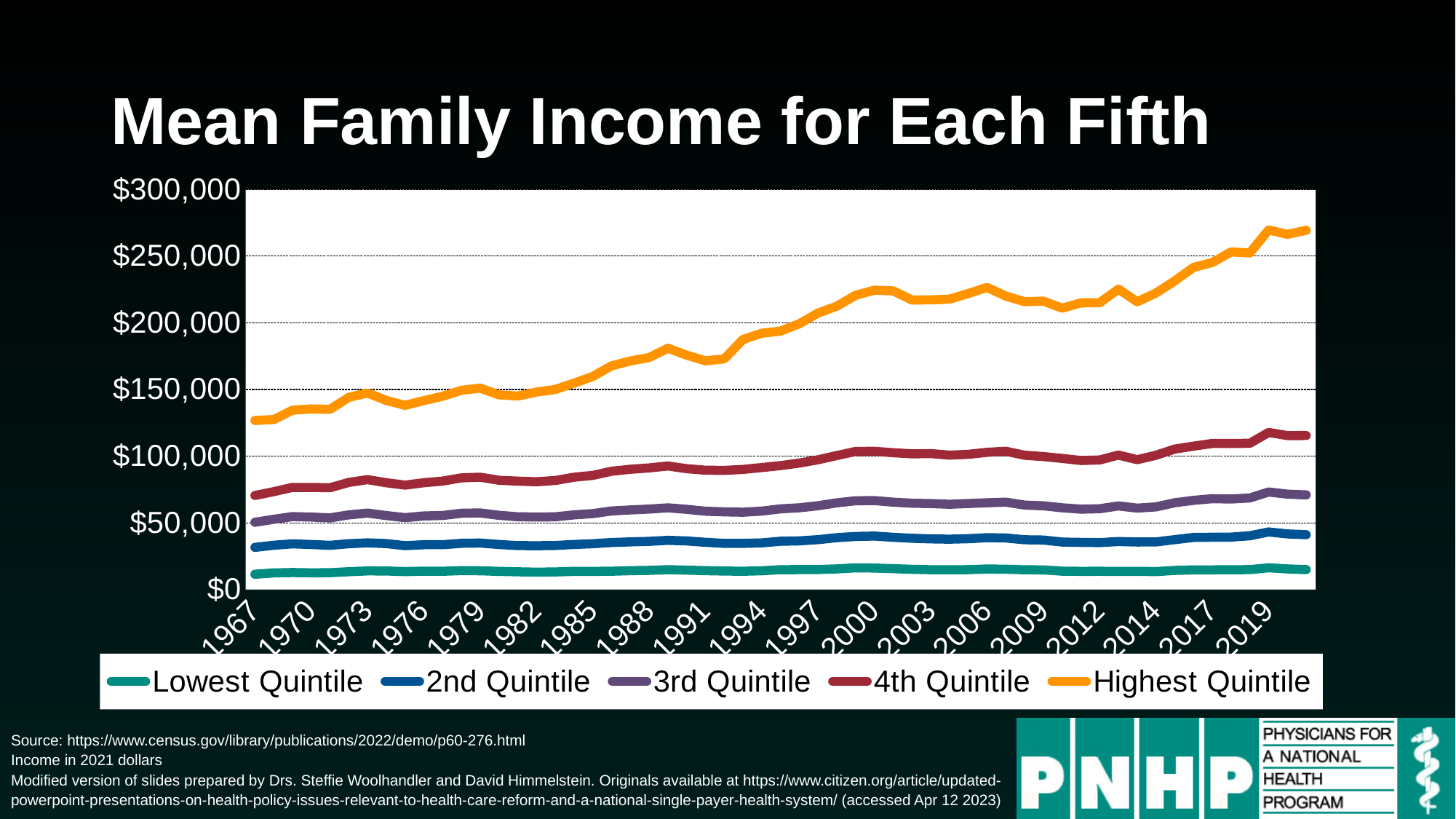
Does the Highest Quintile line generally rise or fall from 1967 to 2019? rise In 2019, which is larger: the Highest Quintile or the 4th Quintile? Highest Quintile Is the value for the Highest Quintile in 1967 greater or less than $150,000? less Which series has the lowest values across the chart? Lowest Quintile Which series has the highest values across the chart? Highest Quintile What is the title of the chart? Mean Family Income for Each Fifth Is the value for the Highest Quintile in 2019 greater or less than $250,000? greater What kind of chart is shown on the slide? line chart Is the value for the 4th Quintile in 2019 greater or less than $100,000? greater How many series does the legend list? 5